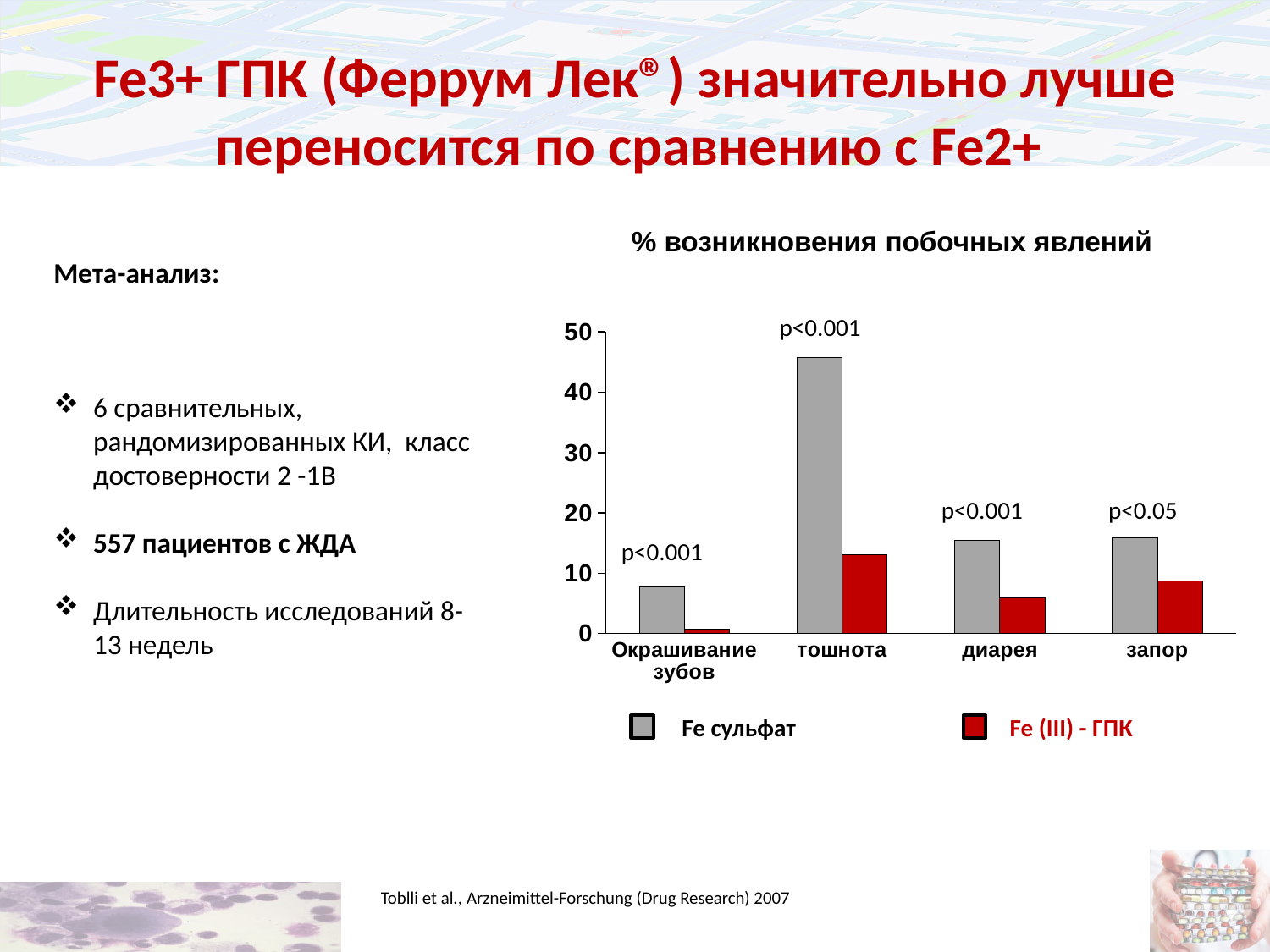
What p-value is printed above the bars for запор? p<0.05 How many categories are shown on the x axis of the chart? 4 What is the title of the chart? % возникновения побочных явлений For which category is the Fe сульфат value highest? тошнота How many series does the chart legend list? 2 For тошнота, which series has the larger value, Fe сульфат or Fe (III) - ГПК? Fe сульфат Is the Fe (III) - ГПК value for диарея greater or less than 10? less For which category is the Fe (III) - ГПК value highest? тошнота What kind of chart is shown on the slide? bar chart Is the Fe сульфат value for Окрашивание зубов greater or less than 10? less Is the Fe сульфат value for тошнота greater or less than 40? greater For which category is the Fe (III) - ГПК value lowest? Окрашивание зубов